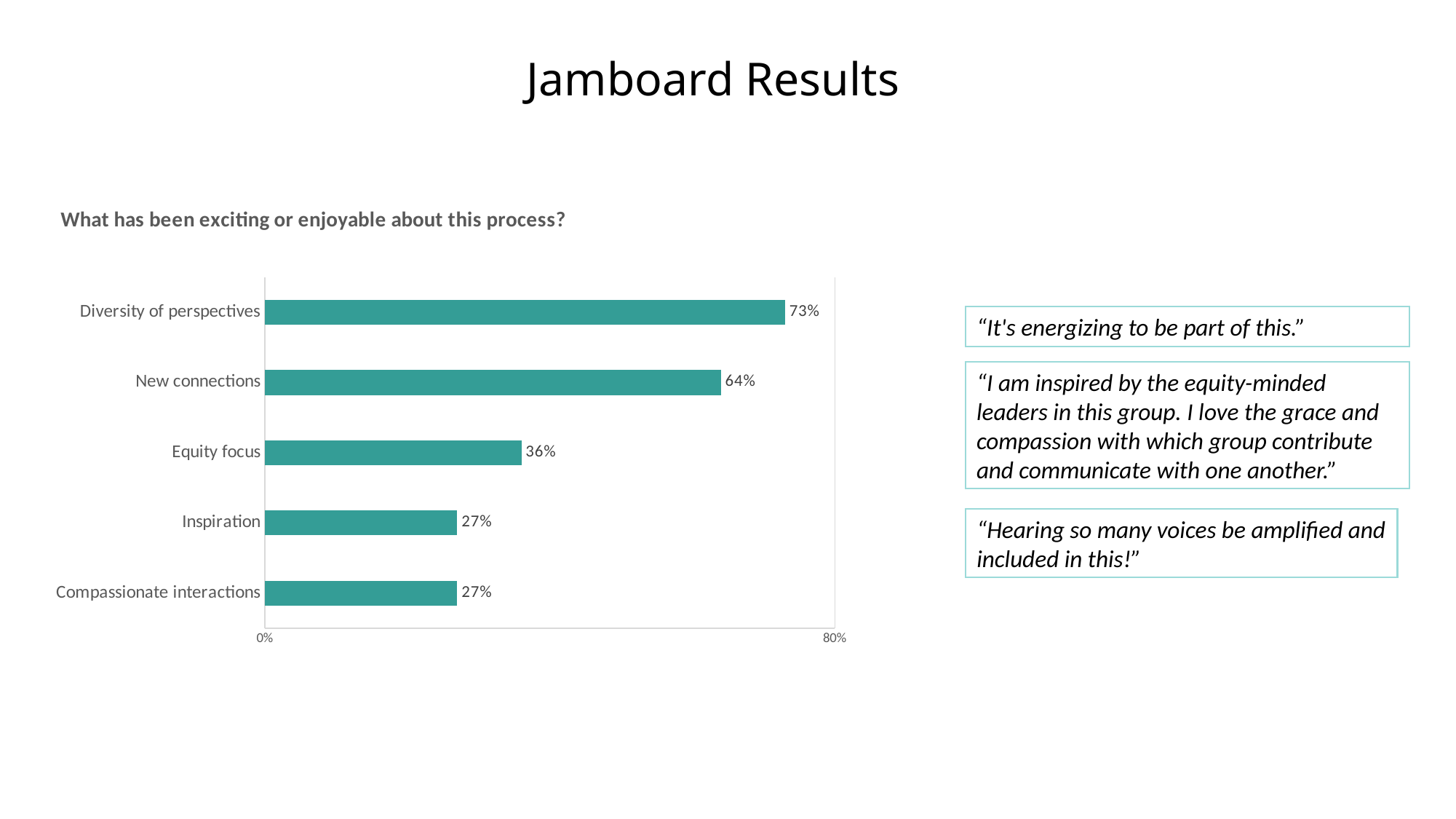
What is the value for Equity focus? 36% What is the value for Inspiration? 27% Which category has the highest value? Diversity of perspectives How many categories are shown in the chart? 5 What is the maximum value shown on the horizontal axis? 80% What is the difference between the values for Diversity of perspectives and New connections? 9% Which is larger, the value for Equity focus or the value for Compassionate interactions? Equity focus What is the title of the chart? What has been exciting or enjoyable about this process? What is the value for New connections? 64% What is the difference between the values for New connections and Equity focus? 28% What kind of chart is shown on the slide? Bar chart What is the value for Diversity of perspectives? 73%